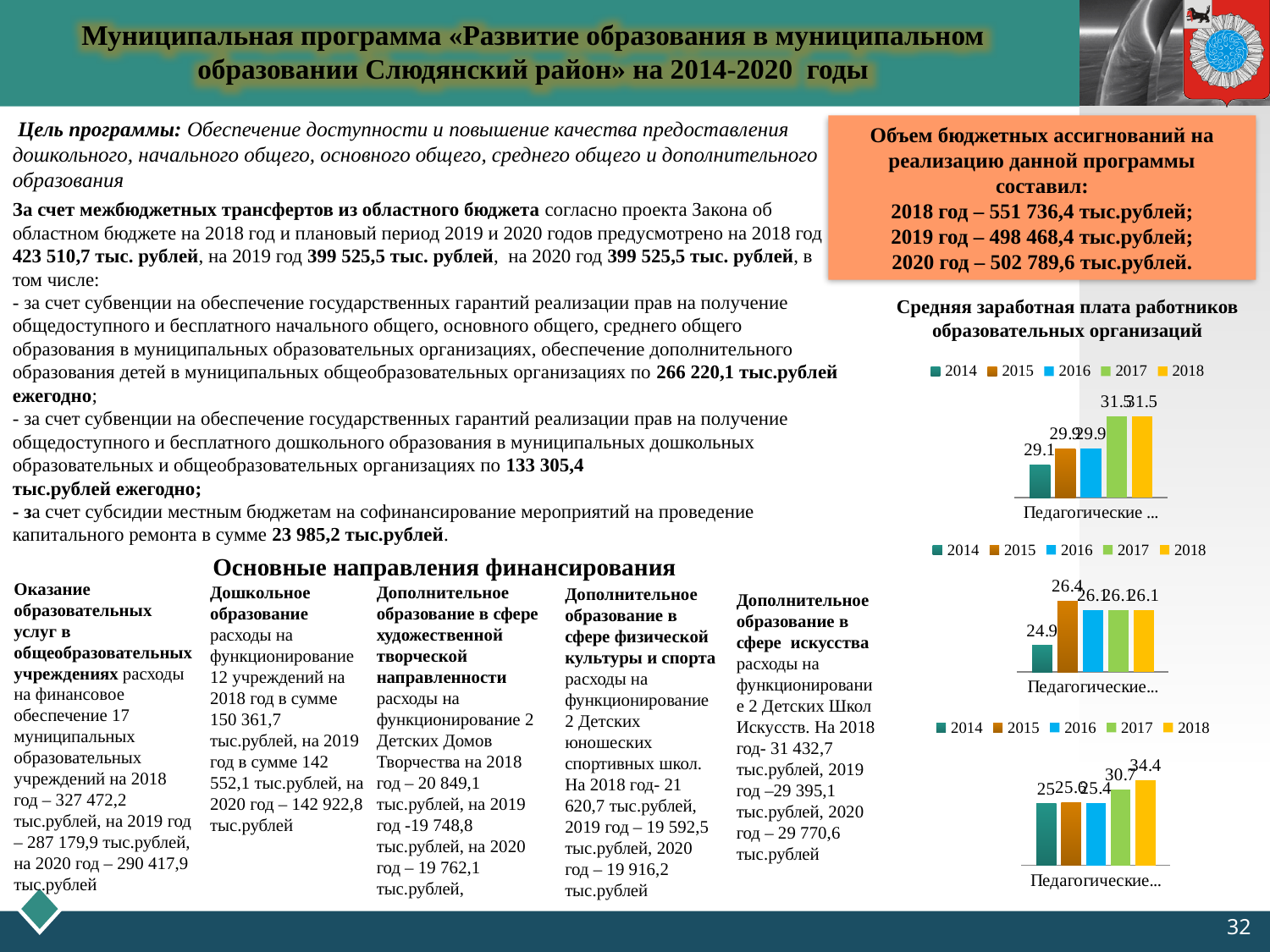
What kind of chart is the top chart on the right side of the slide? bar chart In the middle chart on the right, what is the value for 2014? 24.9 In the bottom chart on the right, what is the difference between the 2018 value (34.4) and the 2017 value (30.7)? 3.7 In the middle chart on the right, what is the difference between the 2015 value (26.4) and the 2014 value (24.9)? 1.5 In the middle chart on the right, which year has the highest value? 2015 How many series does the legend of the top chart on the right list? 5 In the bottom chart on the right, which year has the highest value? 2018 In the top chart on the right, which is larger, the value for 2014 or the value for 2017? 2017 In the top chart on the right, what is the difference between the 2017 value (31.5) and the 2014 value (29.1)? 2.4 In the top chart on the right, which year has the lowest value? 2014 In the bottom chart on the right, what is the value for 2018? 34.4 In the top chart under 'Средняя заработная плата работников образовательных организаций', what is the value for 2014? 29.1